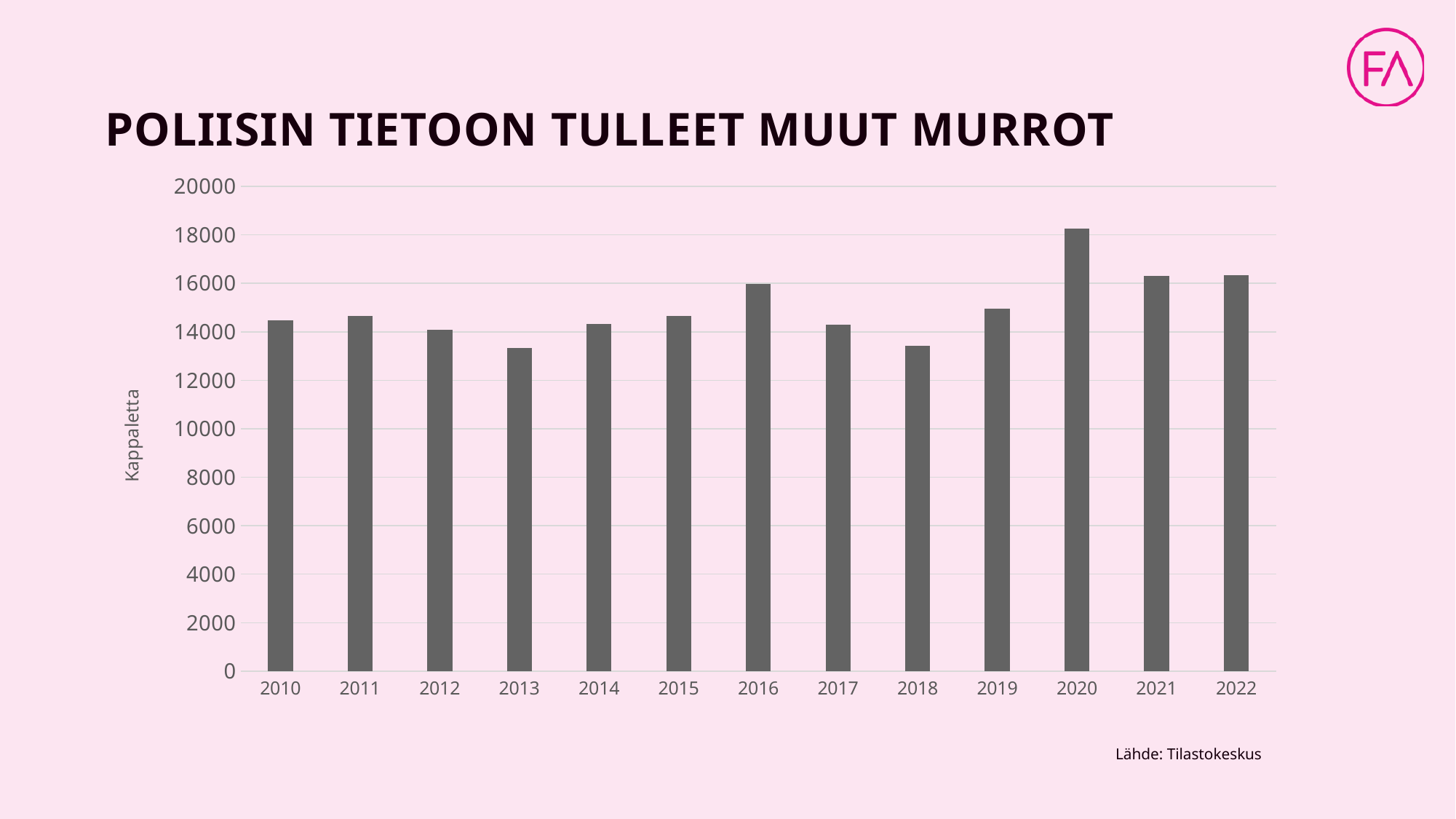
Is the value for 2020 greater or less than 18000? greater Is the value for 2013 greater or less than 14000? less What is the label on the y axis of the chart? Kappaletta Is the value for 2019 greater or less than 14000? greater Do the values rise or fall from 2018 to 2020? rise What kind of chart is shown on the slide? bar chart Which is larger, the value for 2016 or the value for 2013? 2016 How many years are shown on the x axis of the chart? 13 Which is larger, the value for 2020 or the value for 2016? 2020 Which year has the highest number of reported burglaries in the chart? 2020